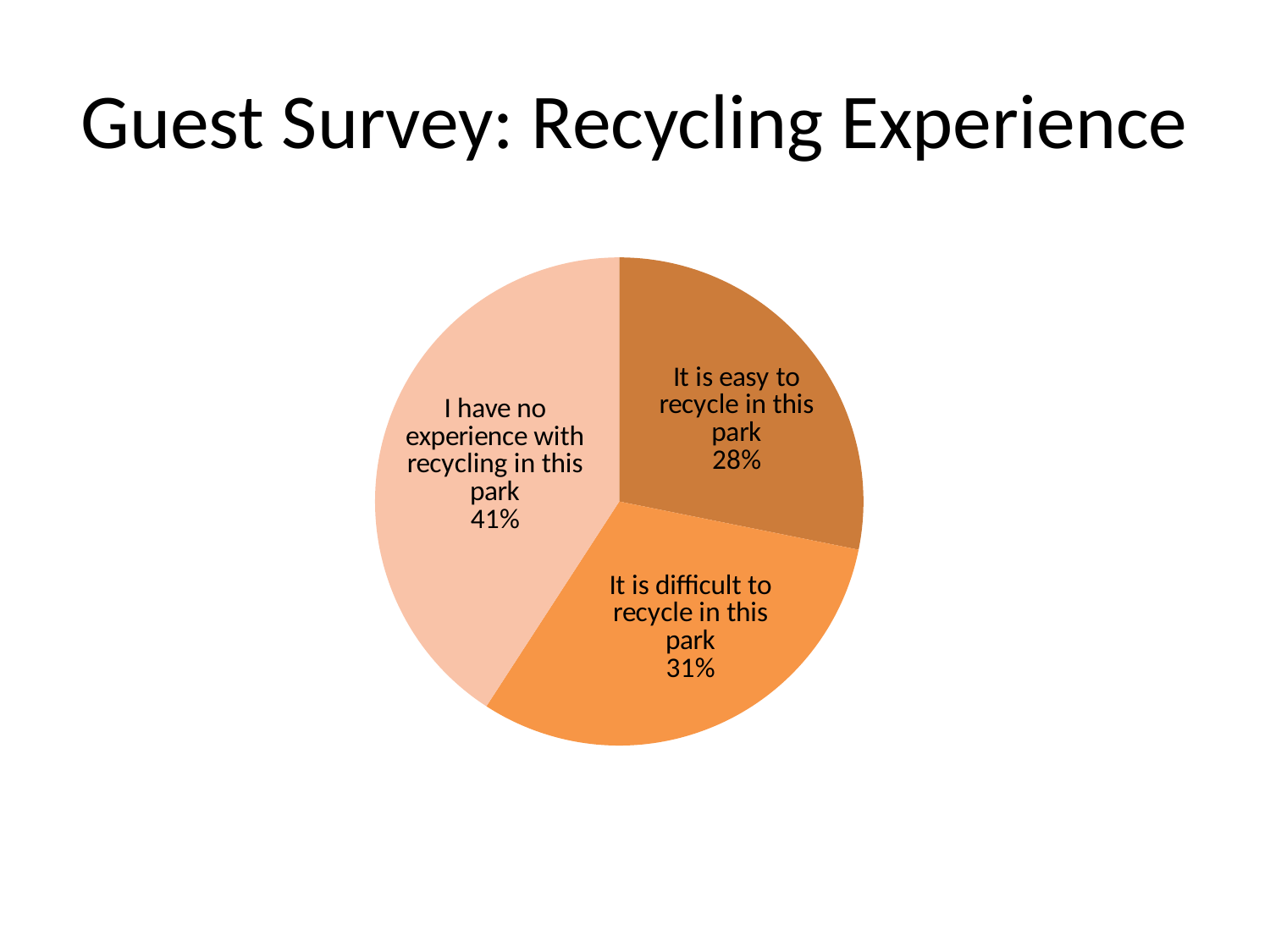
Which response has the largest share of the pie? I have no experience with recycling in this park How many slices does the pie chart have? 3 What is the difference in percentage points between 'It is difficult to recycle in this park' and 'It is easy to recycle in this park'? 3 What is the difference in percentage points between 'I have no experience with recycling in this park' and 'It is easy to recycle in this park'? 13 What type of chart is shown on the slide? Pie chart What percentage of guests said it is difficult to recycle in this park? 31% What is the title of the slide containing the pie chart? Guest Survey: Recycling Experience What percentage of guests said they have no experience with recycling in this park? 41% What percentage of guests said it is easy to recycle in this park? 28% Which response has the smallest share of the pie? It is easy to recycle in this park Which slice of the pie chart is the lightest in colour? I have no experience with recycling in this park Which is larger: the share for 'It is difficult to recycle in this park' or 'It is easy to recycle in this park'? It is difficult to recycle in this park